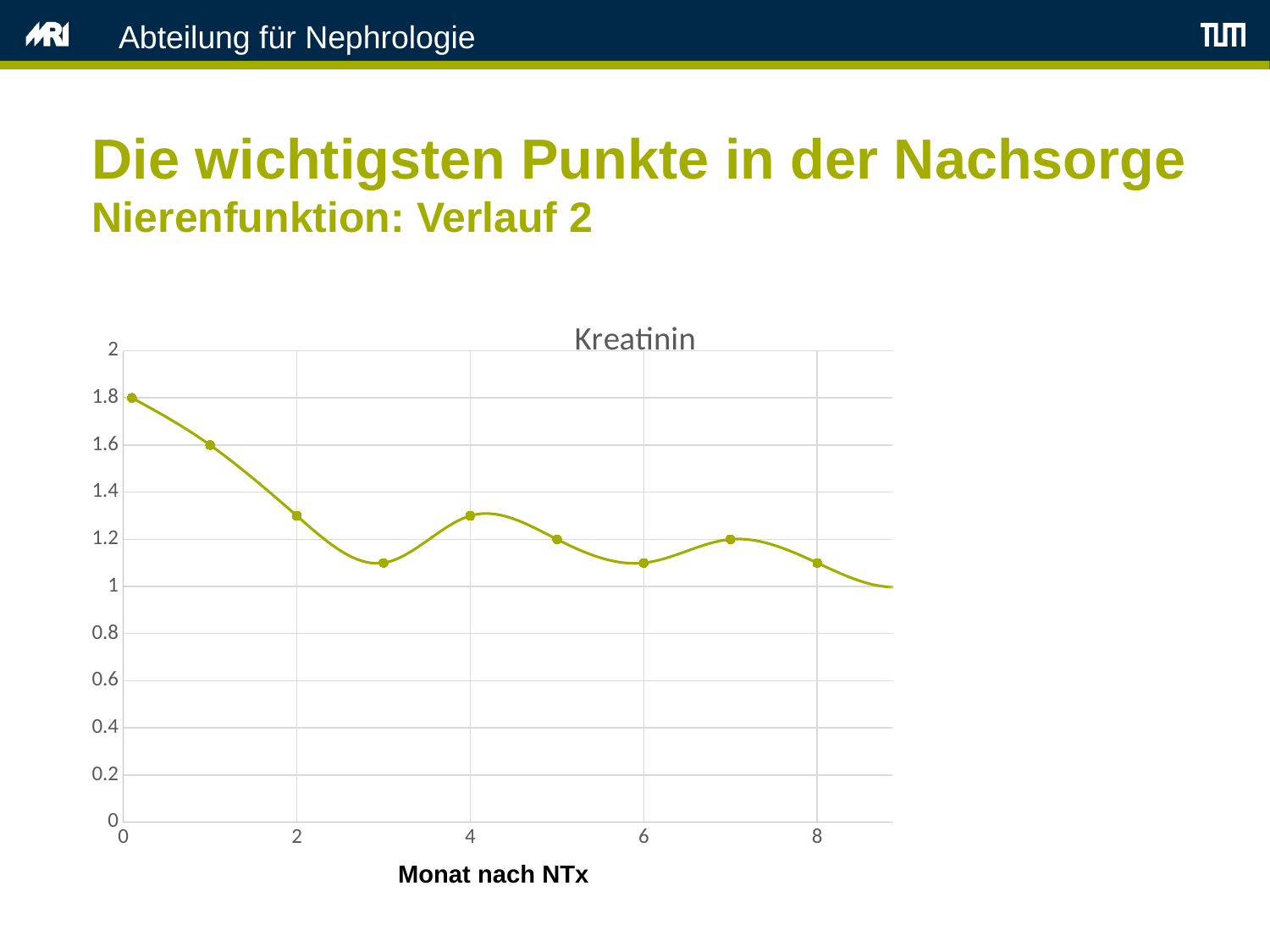
What is the title of the chart? Kreatinin At which month after NTx is the Kreatinin value highest? 0 Is the Kreatinin value at month 2 greater or less than 1.2? greater What is the label of the x axis? Monat nach NTx What is the Kreatinin value at month 1 after NTx? 1.6 Overall, do the Kreatinin values rise or fall from month 0 to month 8? fall Is the Kreatinin value at month 3 greater or less than 1.2? less Which is larger, the Kreatinin value at month 0 or at month 8? month 0 What is the Kreatinin value at month 5 after NTx? 1.2 What is the difference between the Kreatinin values at month 0 and month 1? 0.2 What kind of chart is shown on the slide? line chart What is the Kreatinin value at month 0 after NTx? 1.8